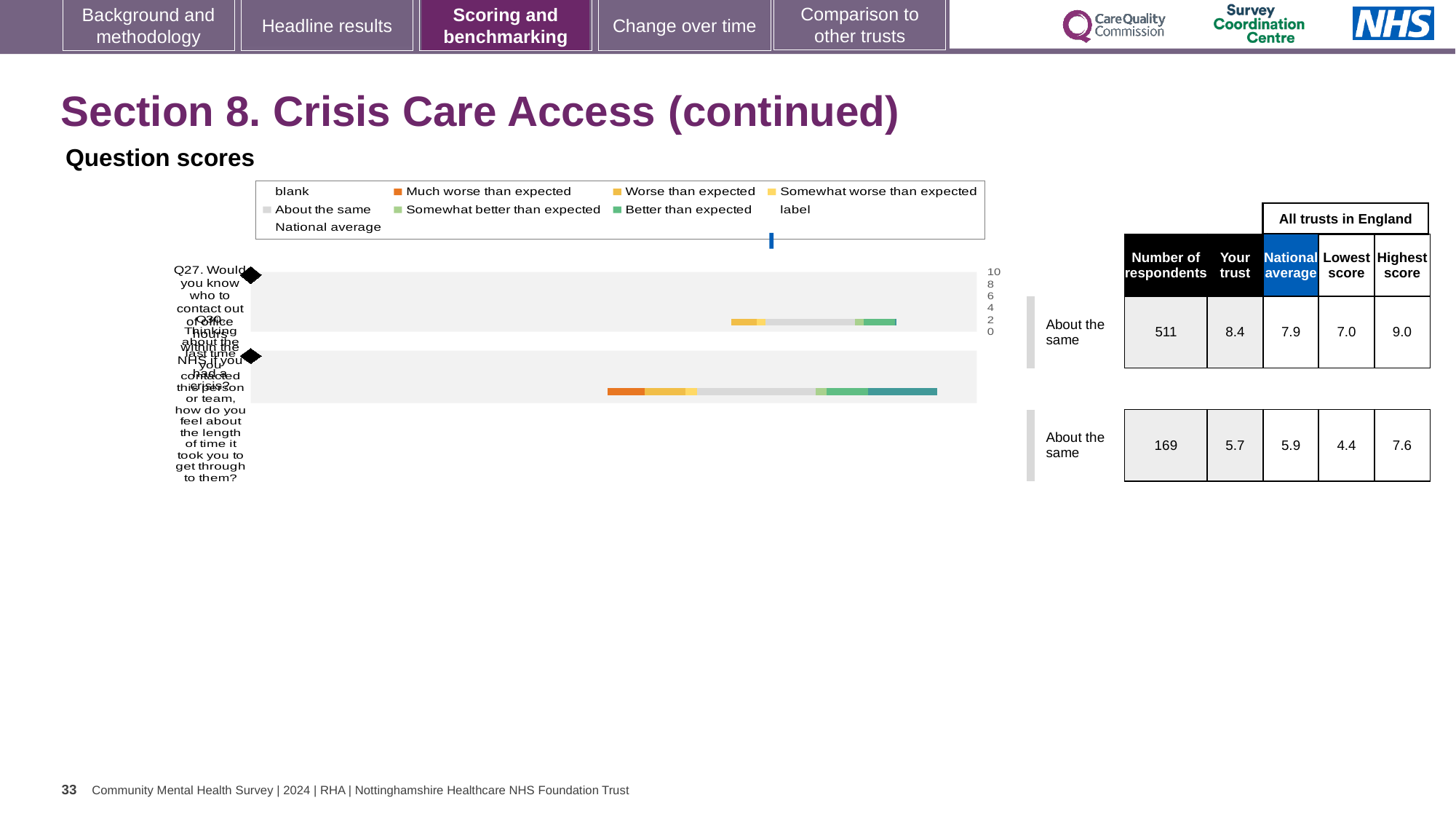
In the question scores chart, which row has more respondents, Q27 (top) or Q30 (bottom)? Q27 In the question scores chart, what is the difference between the highest and lowest scores for Q30 (the bottom row)? 3.2 In the question scores chart, what is the national average for Q30 (the bottom row)? 5.9 In the question scores chart, what is the number of respondents for Q27 (the top row)? 511 In the question scores chart, what is the highest score across all trusts in England for Q30 (the bottom row)? 7.6 In the question scores chart, what is the difference between the 'Your trust' score and the national average for Q27 (the top row)? 0.5 In the question scores chart legend, which category is shown in orange? Much worse than expected In the question scores chart, what is the 'Your trust' score for Q27 (the top row)? 8.4 What kind of chart is used to show the question scores on this slide? bar chart In the question scores chart, which is larger for Q30 (the bottom row): the 'Your trust' score or the national average? National average How many questions (bars) are plotted in the question scores chart? 2 In the question scores chart, what is the lowest score across all trusts in England for Q27 (the top row)? 7.0